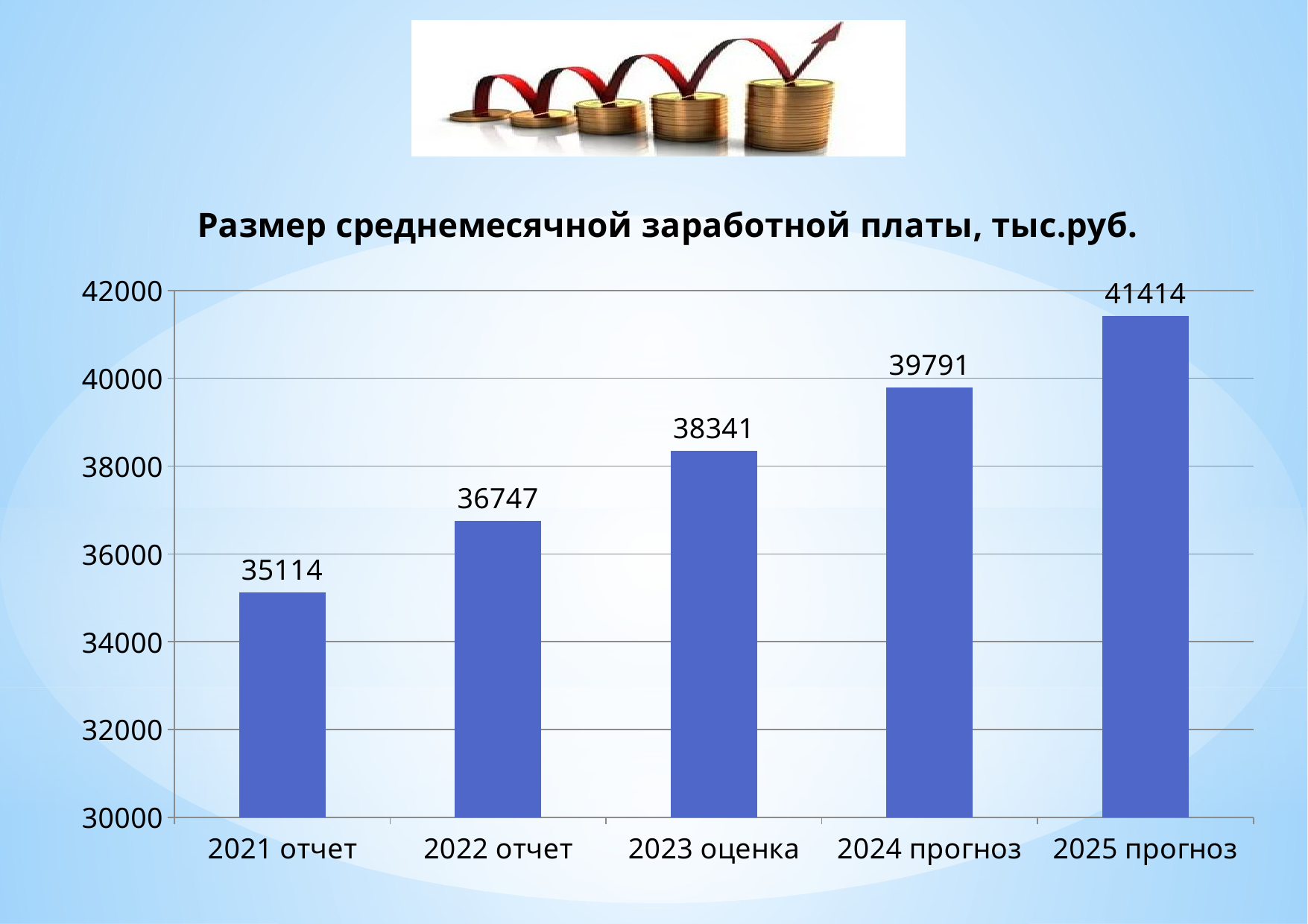
What is the difference between the values for 2025 прогноз and 2021 отчет? 6300 Which category has the lowest value? 2021 отчет What is the value for 2023 оценка? 38341 Do the values rise or fall from 2021 отчет to 2025 прогноз? rise What is the difference between the values for 2024 прогноз and 2023 оценка? 1450 How many categories are shown on the x axis? 5 What kind of chart is shown on the slide? bar chart Which category has the highest value? 2025 прогноз Which is larger, the value for 2022 отчет or the value for 2024 прогноз? 2024 прогноз Is the value for 2022 отчет greater or less than 36000? greater What is the value for 2025 прогноз? 41414 What is the value for 2021 отчет? 35114